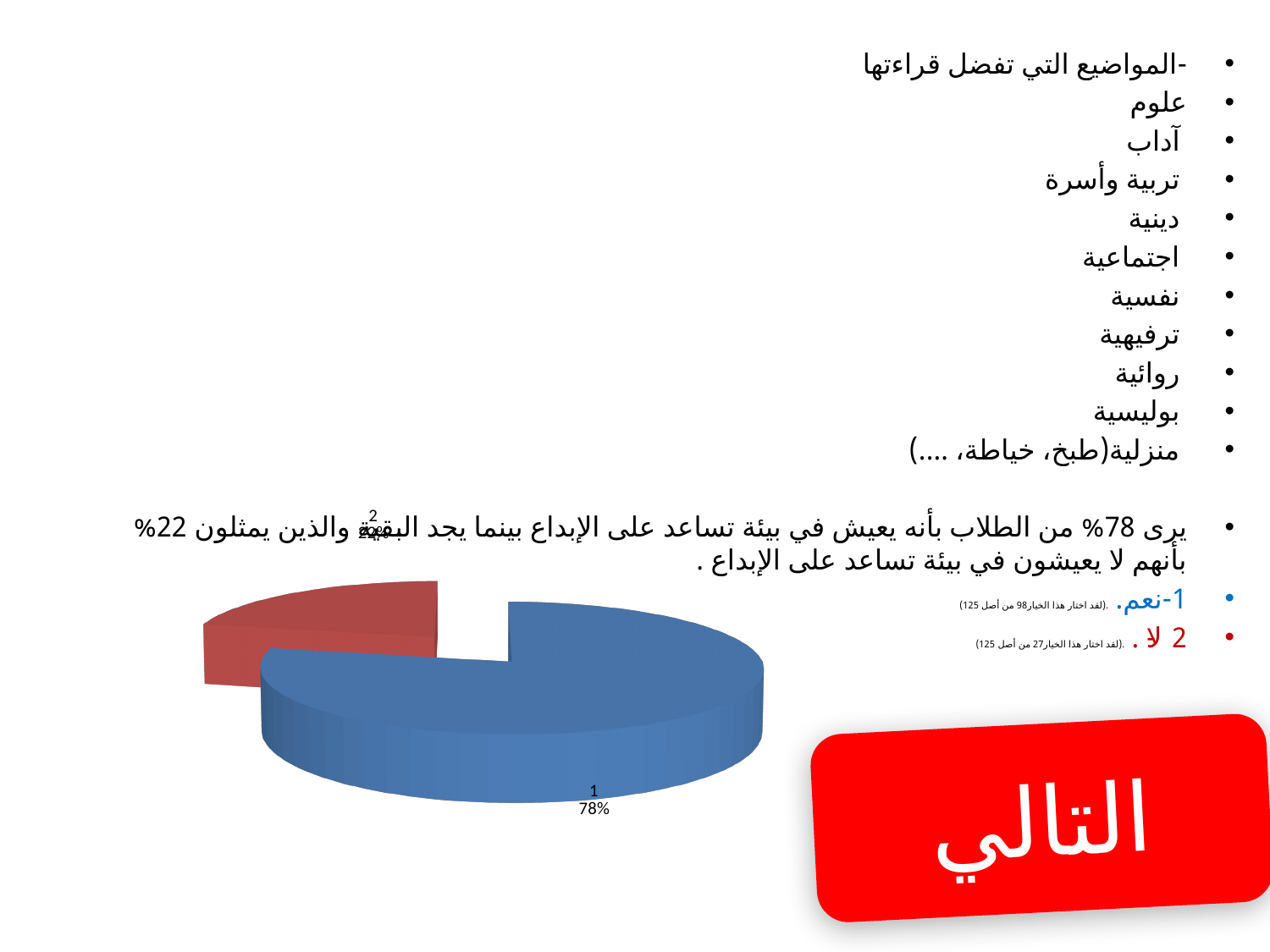
What kind of chart is shown on the slide? pie chart How many slices does the pie chart have? 2 Is the share of slice 1 in the pie chart greater or less than 50%? greater What colour is slice 2 in the pie chart? red Which slice of the pie chart is the largest? 1 What colour is slice 1 in the pie chart? blue What percentage is shown for slice 1 in the pie chart? 78% Which slice of the pie chart is the smallest? 2 Which slice is larger in the pie chart, slice 1 or slice 2? 1